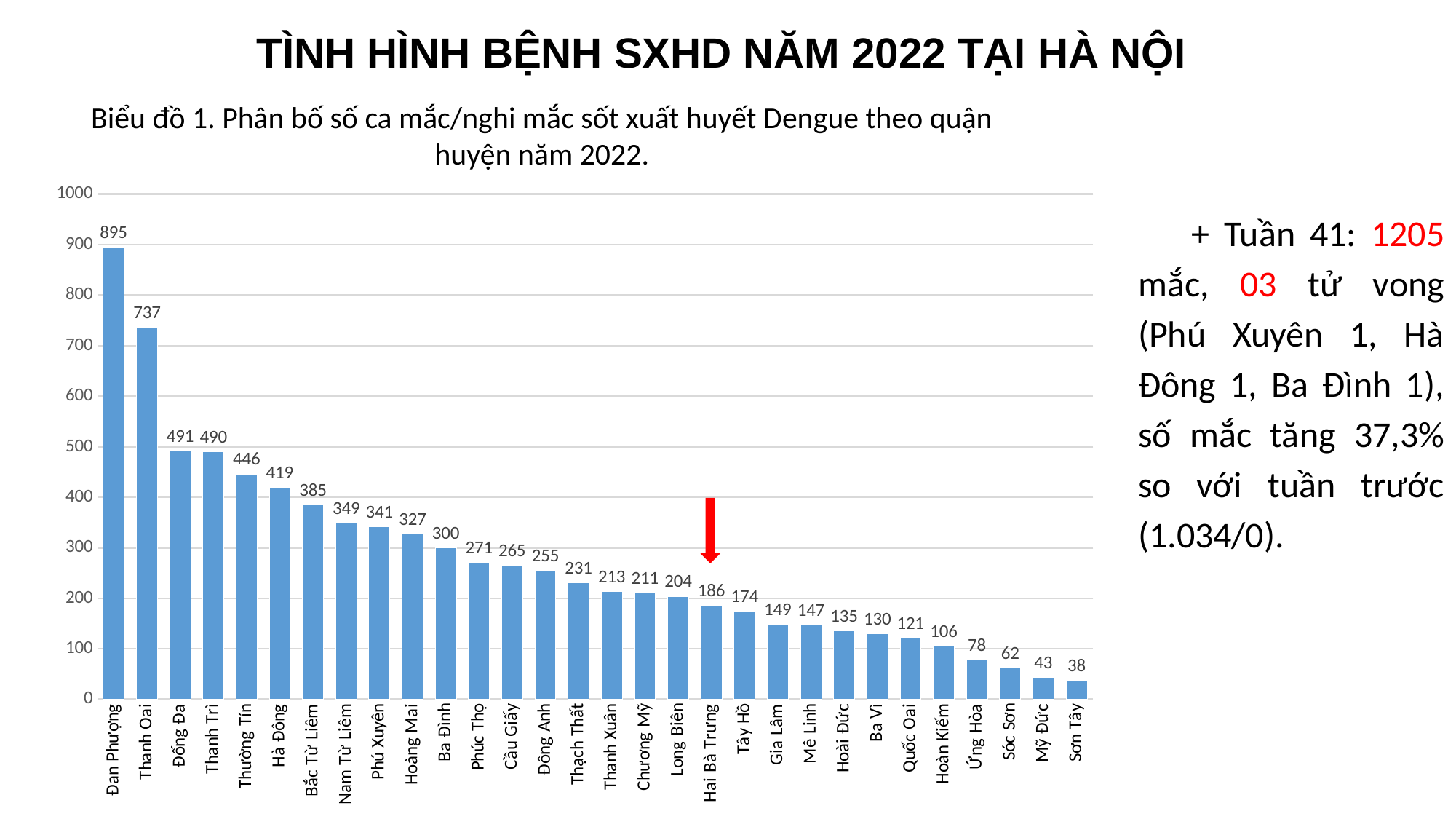
What is the value for Hoàn Kiếm? 106 What is the value for Đan Phượng? 895 Which district has the lowest value? Sơn Tây What is the difference between the values for Mỹ Đức and Sơn Tây? 5 Which is larger, the value for Hà Đông or the value for Bắc Từ Liêm? Hà Đông Do the values rise or fall from left to right along the x axis? Fall Which district has the highest value? Đan Phượng Is the value for Thanh Oai greater or less than 700? greater What is the value for Hai Bà Trưng? 186 How many districts are shown on the chart? 30 What kind of chart is shown on the slide? Bar chart What is the difference between the values for Đan Phượng and Thanh Oai? 158